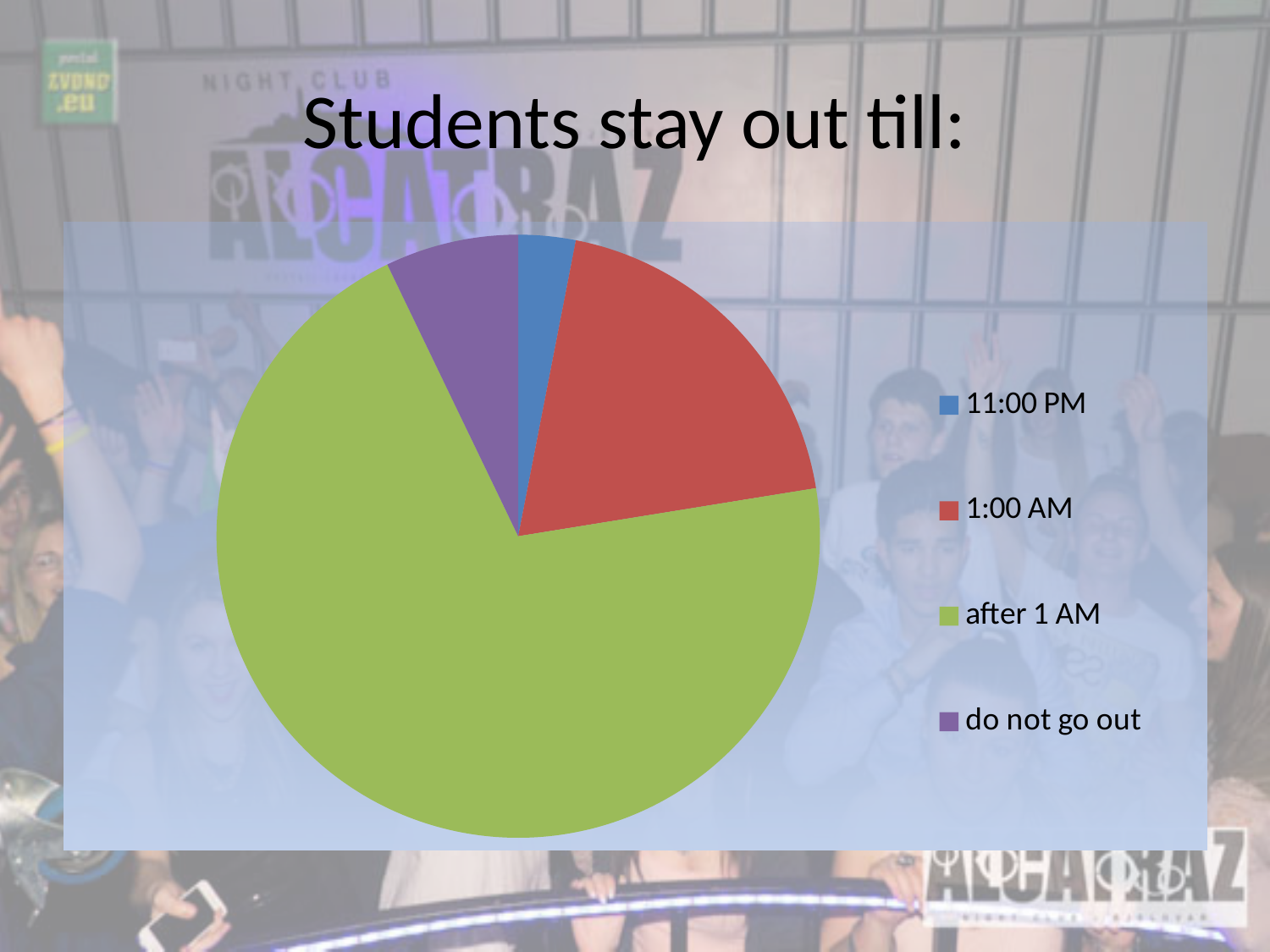
Which slice is larger, do not go out or 11:00 PM? do not go out Which category has the smallest slice of the pie? 11:00 PM Which category has the largest slice of the pie? after 1 AM What kind of chart is shown on the slide? pie chart What colour is the slice for after 1 AM? green What is the title of the chart? Students stay out till: Which slice is larger, after 1 AM or 1:00 AM? after 1 AM How many categories does the pie chart have? 4 Which slice is larger, 1:00 AM or do not go out? 1:00 AM Which category is shown in red in the legend? 1:00 AM